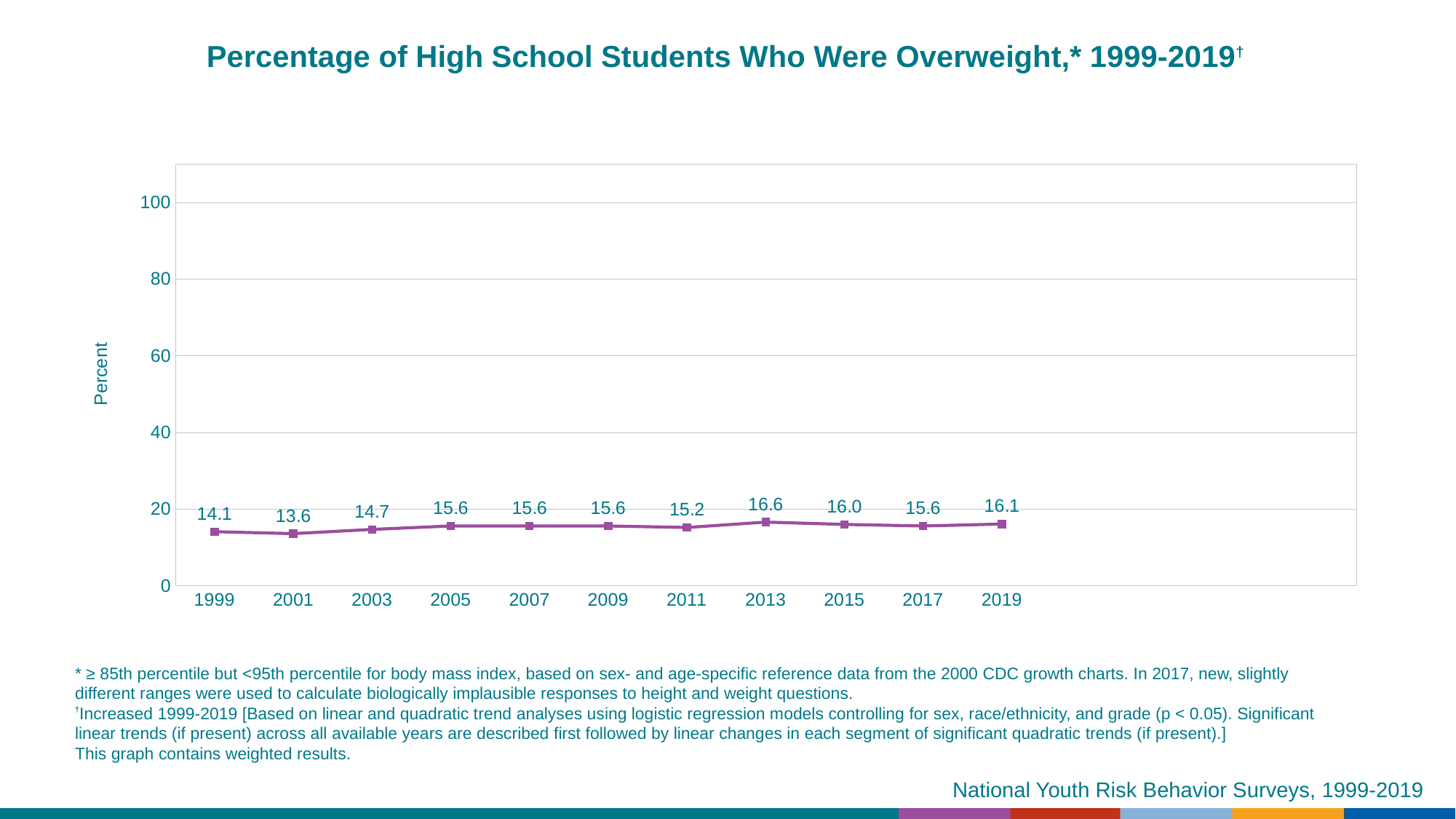
What was the percentage of high school students who were overweight in 1999? 14.1 Which year has the lowest percentage of overweight high school students? 2001 Which year has the highest percentage of overweight high school students? 2013 Which is larger, the value for 2003 or the value for 2015? 2015 How many years are plotted on the chart? 11 What is the difference between the 2019 value and the 1999 value? 2.0 What kind of chart is shown on the slide? line chart What was the percentage of high school students who were overweight in 2019? 16.1 What value is shown for 2011? 15.2 Is the value for 2013 greater or less than 20? less What is the label on the vertical axis? Percent What is the difference between the 2013 value and the 2001 value? 3.0